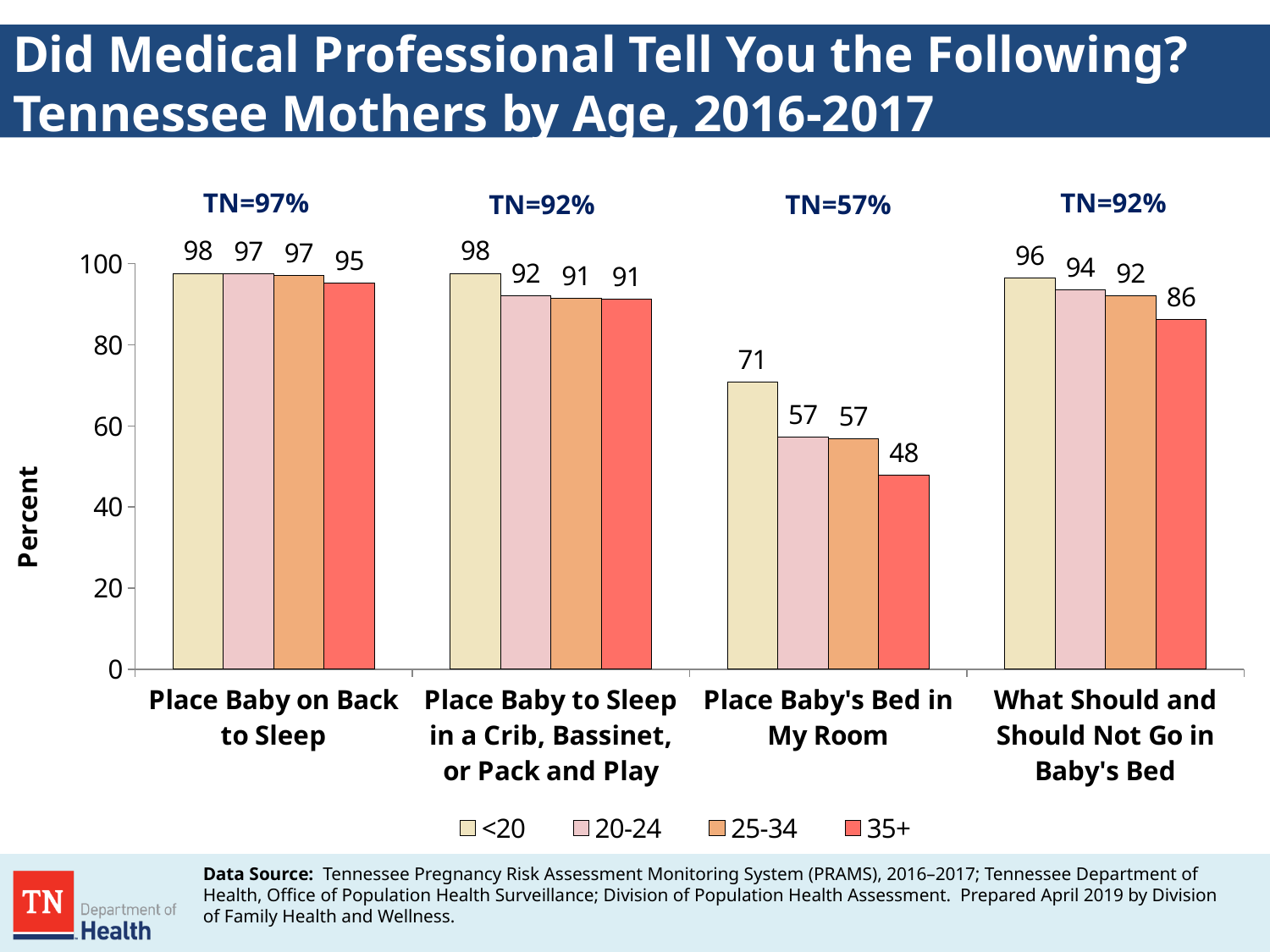
What is the value for the 35+ age group for "Place Baby's Bed in My Room"? 48 Which age group has the highest value for "Place Baby's Bed in My Room"? <20 What is the difference between the <20 and 35+ values for "What Should and Should Not Go in Baby's Bed"? 10 What is the overall Tennessee percentage (TN=) shown above "Place Baby's Bed in My Room"? 57% How many categories are shown on the x axis? 4 What is the value for the <20 age group for "Place Baby to Sleep in a Crib, Bassinet, or Pack and Play"? 98 What is the difference between the <20 and 35+ values for "Place Baby's Bed in My Room"? 23 Which category has the lowest value for the 35+ age group? Place Baby's Bed in My Room How many series does the legend list? 4 What is the value for the 35+ age group for "What Should and Should Not Go in Baby's Bed"? 86 Which is larger: the 20-24 value for "Place Baby on Back to Sleep" or the 20-24 value for "Place Baby's Bed in My Room"? Place Baby on Back to Sleep What kind of chart is shown on the slide? Bar chart